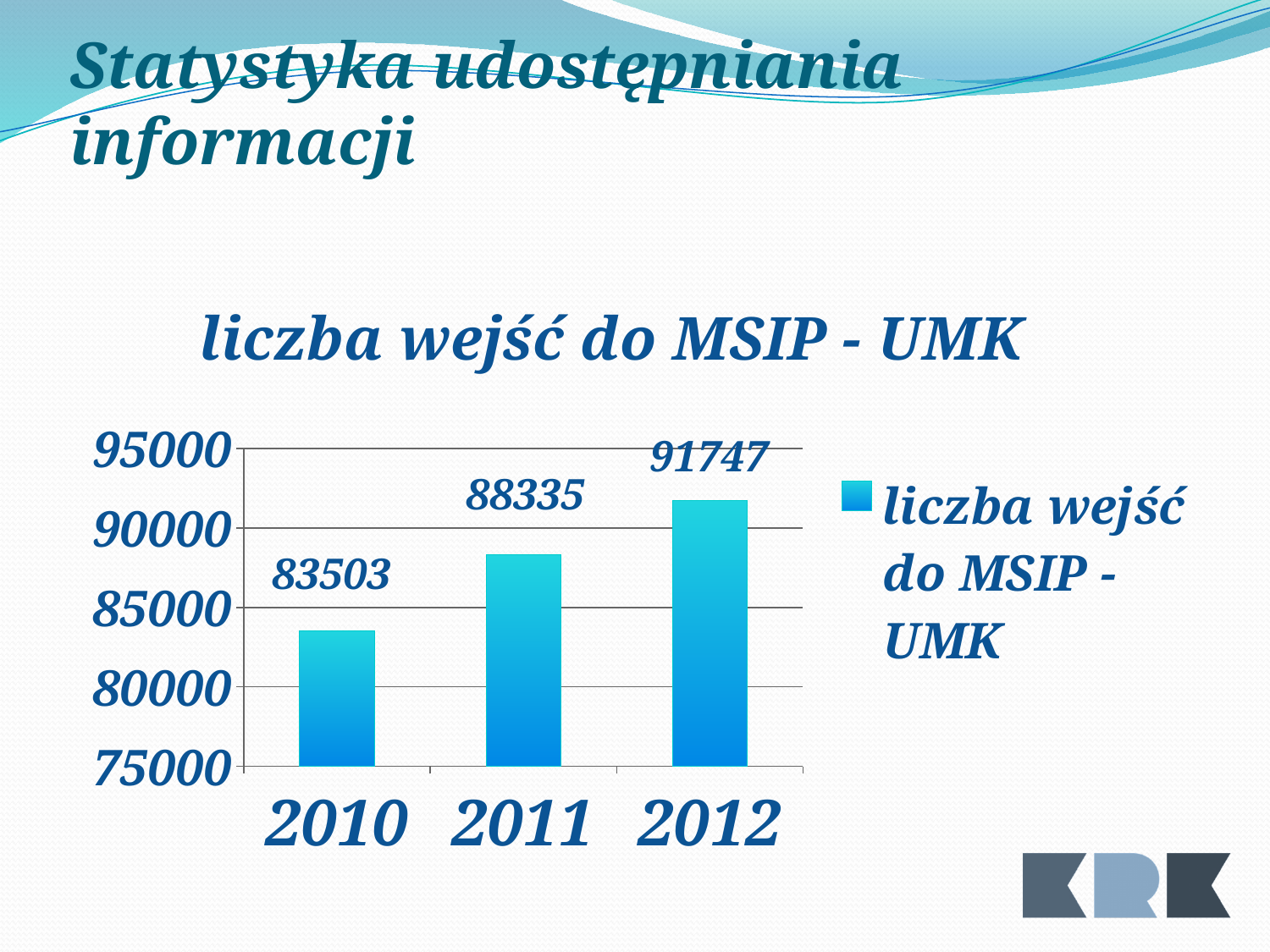
What kind of chart is shown on the slide? bar chart Which year has more visits, 2011 or 2012? 2012 What is the difference between the number of visits in 2012 and in 2010? 8244 Which year has the highest number of visits? 2012 What is the number of visits to MSIP - UMK in 2011? 88335 Do the values rise or fall from 2010 to 2012? rise How many years are shown on the x axis? 3 Which year has the lowest number of visits? 2010 What is the difference between the number of visits in 2011 and in 2010? 4832 What is the number of visits to MSIP - UMK in 2010? 83503 Is the value for 2012 greater or less than 90000? greater What is the number of visits to MSIP - UMK in 2012? 91747